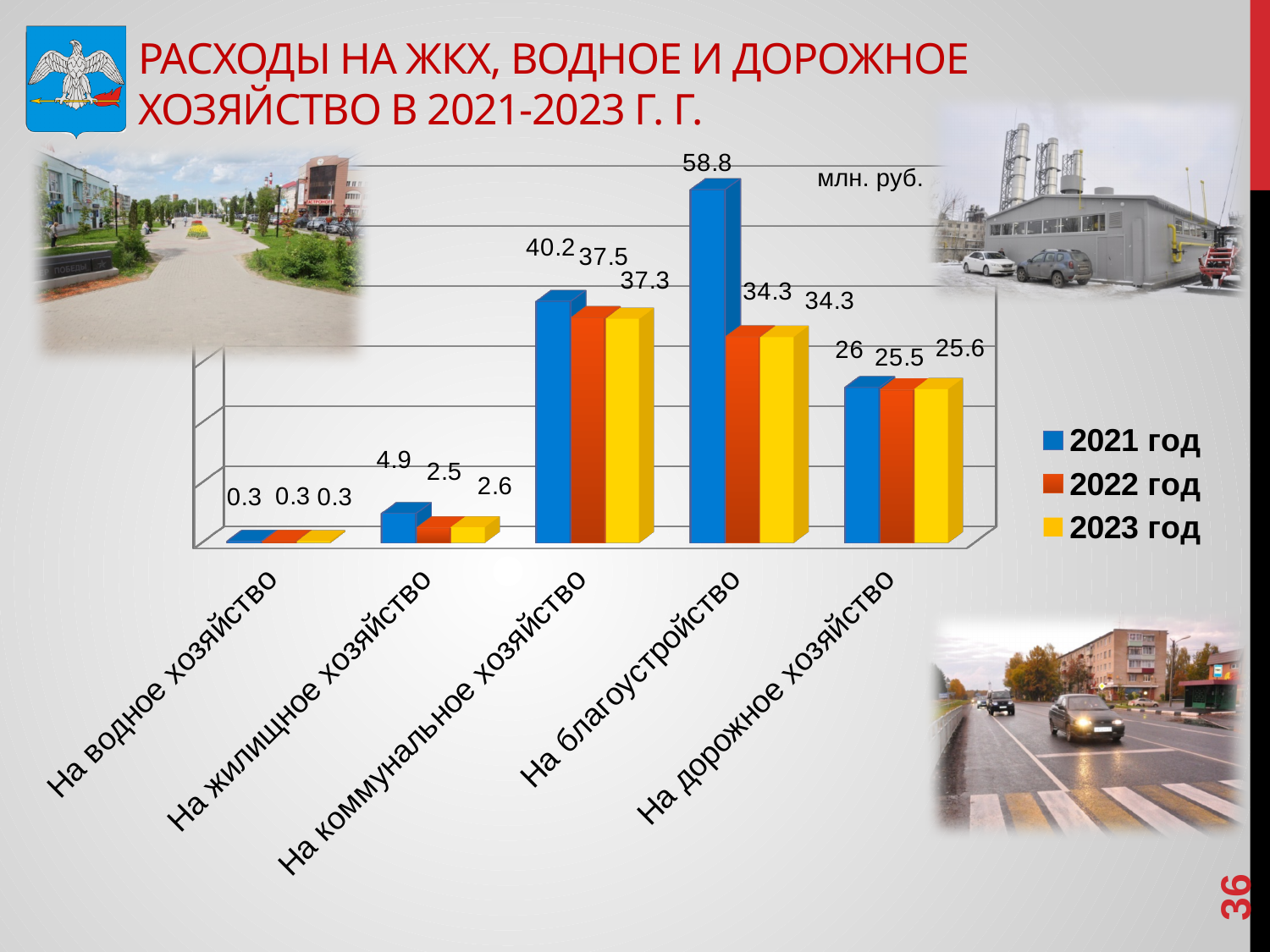
How many series does the legend list? 3 What unit is indicated on the chart? млн. руб. What is the value for 2021 год for На благоустройство? 58.8 Which category has the lowest value for 2023 год? На водное хозяйство How many categories are shown on the x axis? 5 What is the value for 2023 год for На коммунальное хозяйство? 37.3 What is the value for 2022 год for На жилищное хозяйство? 2.5 What is the value for 2021 год for На дорожное хозяйство? 26 Which category has the highest value for 2021 год? На благоустройство Which is larger for На коммунальное хозяйство: the 2021 год value or the 2022 год value? 2021 год What is the difference between the 2021 год and 2022 год values for На благоустройство? 24.5 What kind of chart is shown on the slide? Bar chart